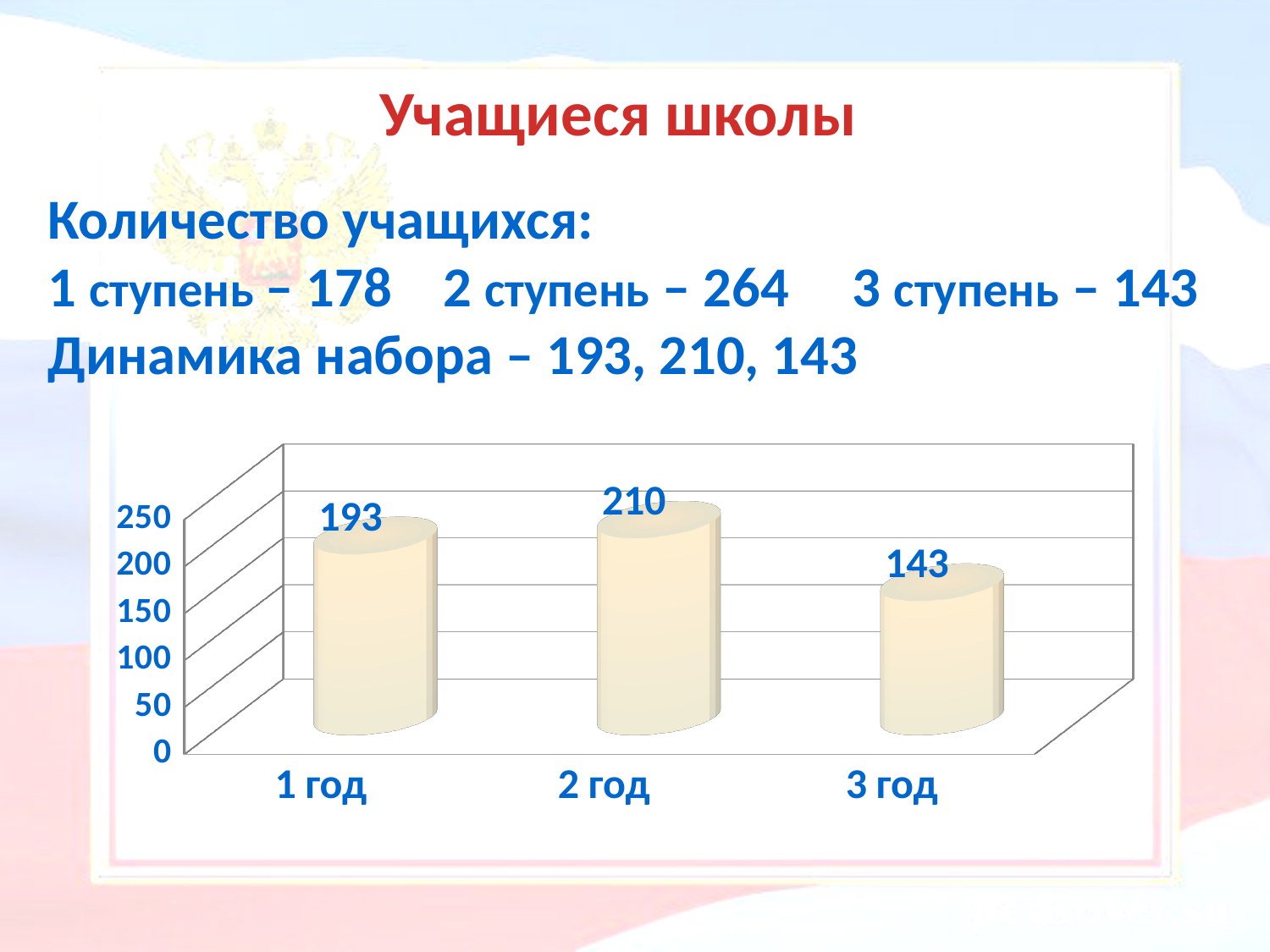
What is the difference between the values for 2 год and 1 год? 17 What kind of chart is shown on the slide? bar chart What is the highest tick value shown on the vertical axis? 250 How many categories are shown on the x axis? 3 Is the value for 2 год greater or less than 200? greater Which category has the lowest value? 3 год Which category has the highest value? 2 год What is the value for 3 год? 143 What is the value for 2 год? 210 What is the difference between the values for 1 год and 3 год? 50 Which is larger, the value for 1 год or the value for 3 год? 1 год What is the value for 1 год? 193